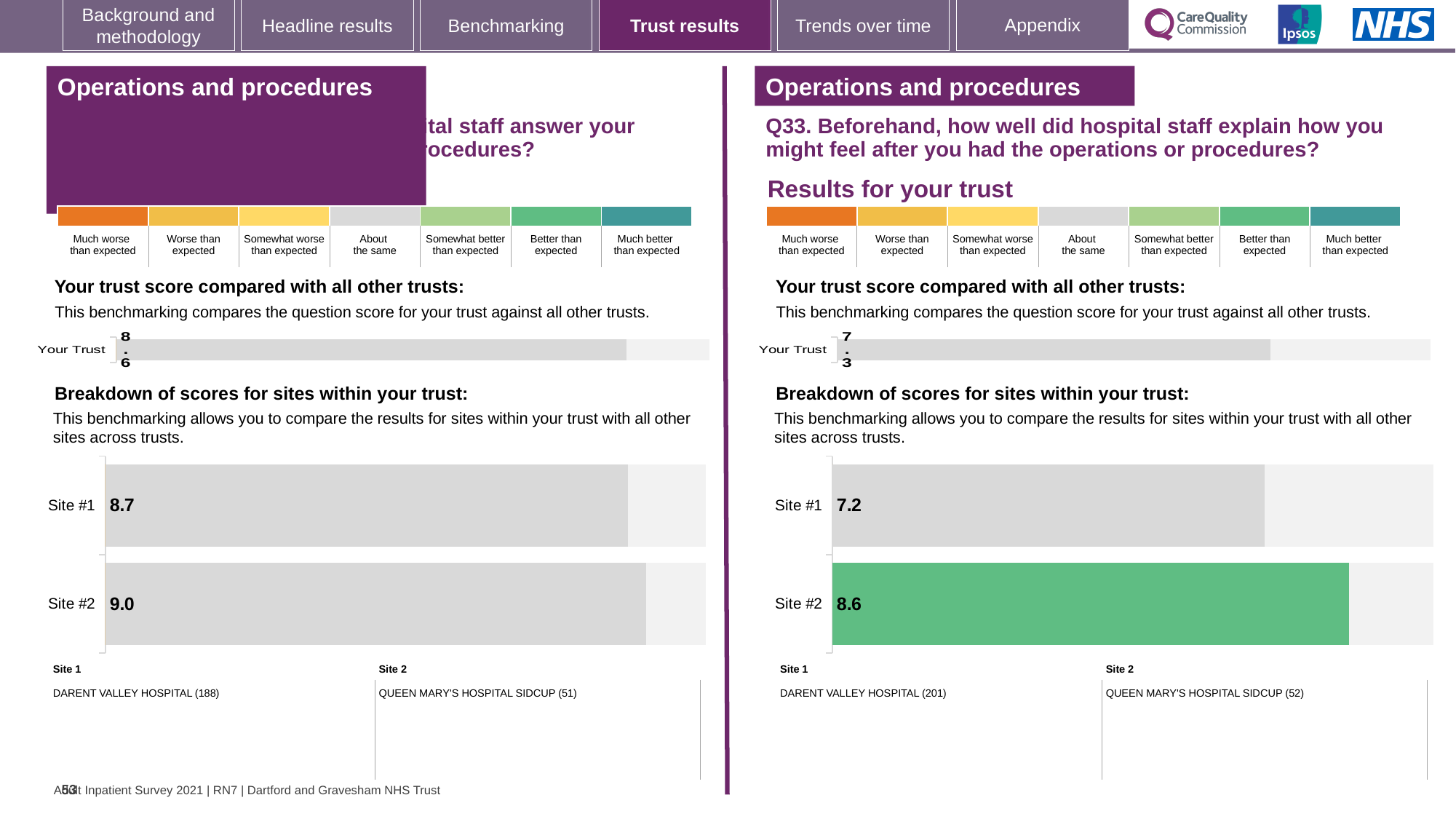
What type of chart is used for the site breakdown on the right-hand side (Q33)? Bar chart On the right-hand 'Breakdown of scores for sites within your trust' chart (Q33), what is the score for Site #2? 8.6 On the left-hand 'Breakdown of scores for sites within your trust' chart, what is the score for Site #1? 8.7 On the left-hand site breakdown chart, what is the difference between the Site #2 and Site #1 scores? 0.3 On the left-hand 'Your trust score compared with all other trusts' chart, what is the score for Your Trust? 8.6 On the right-hand 'Your trust score compared with all other trusts' chart (Q33), what is the score for Your Trust? 7.3 On the left-hand site breakdown chart, which site has the lower score? Site #1 How many sites are shown on the right-hand site breakdown chart (Q33)? 2 On the right-hand site breakdown chart (Q33), what is the difference between the Site #2 and Site #1 scores? 1.4 On the right-hand 'Breakdown of scores for sites within your trust' chart (Q33), what is the score for Site #1? 7.2 On the right-hand site breakdown chart (Q33), which site has the higher score? Site #2 On the left-hand 'Breakdown of scores for sites within your trust' chart, what is the score for Site #2? 9.0